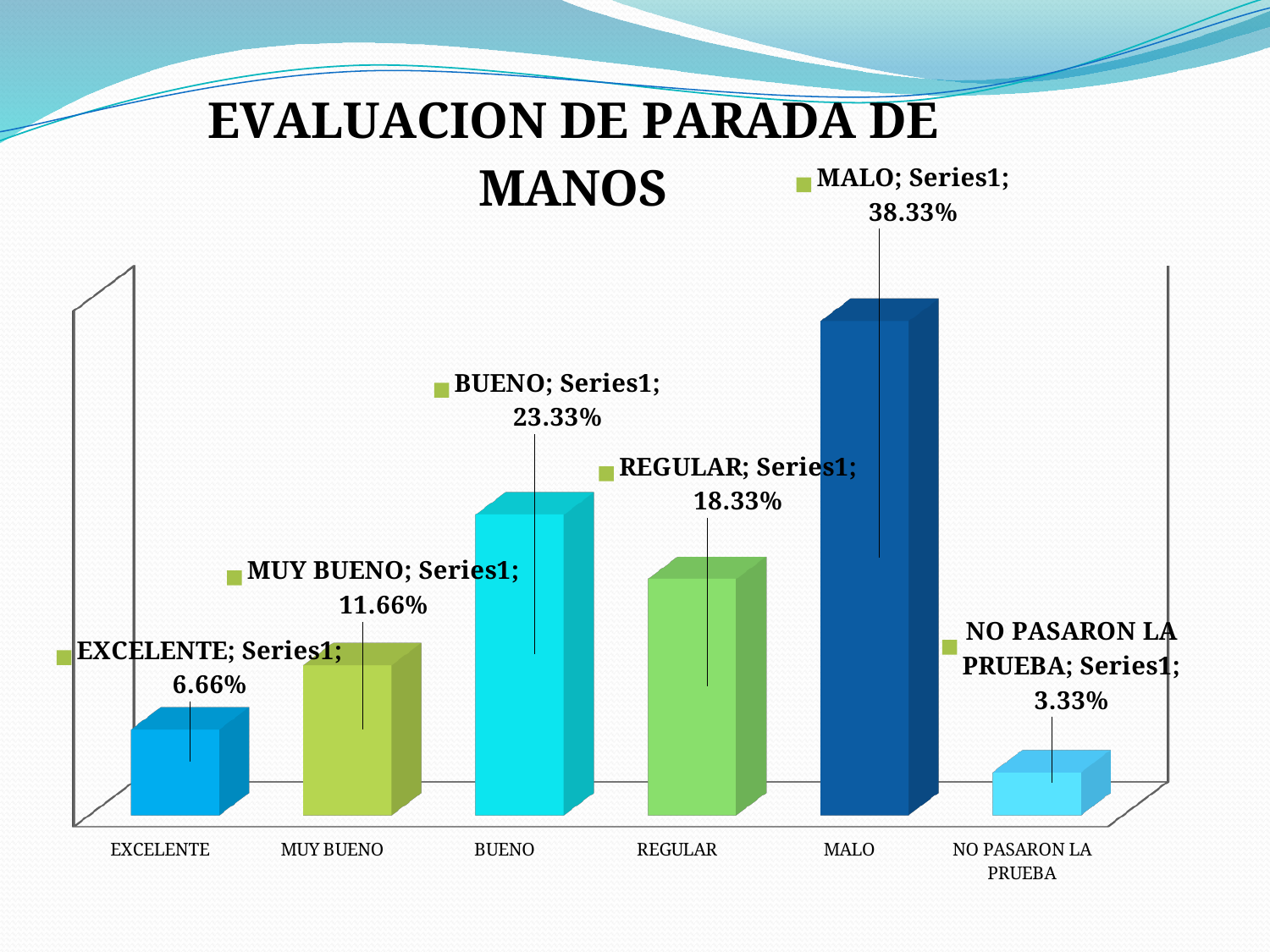
What is the difference between the values for MALO and BUENO? 15.00% What is the value for MALO? 38.33% What is the value for EXCELENTE? 6.66% What is the value for NO PASARON LA PRUEBA? 3.33% What is the difference between the values for REGULAR and MUY BUENO? 6.67% What kind of chart is shown on the slide? bar chart Which is larger, the value for BUENO or the value for REGULAR? BUENO What is the value for BUENO? 23.33% What is the title of the chart? EVALUACION DE PARADA DE MANOS Which category has the highest value? MALO How many categories are shown on the x axis? 6 Which category has the lowest value? NO PASARON LA PRUEBA